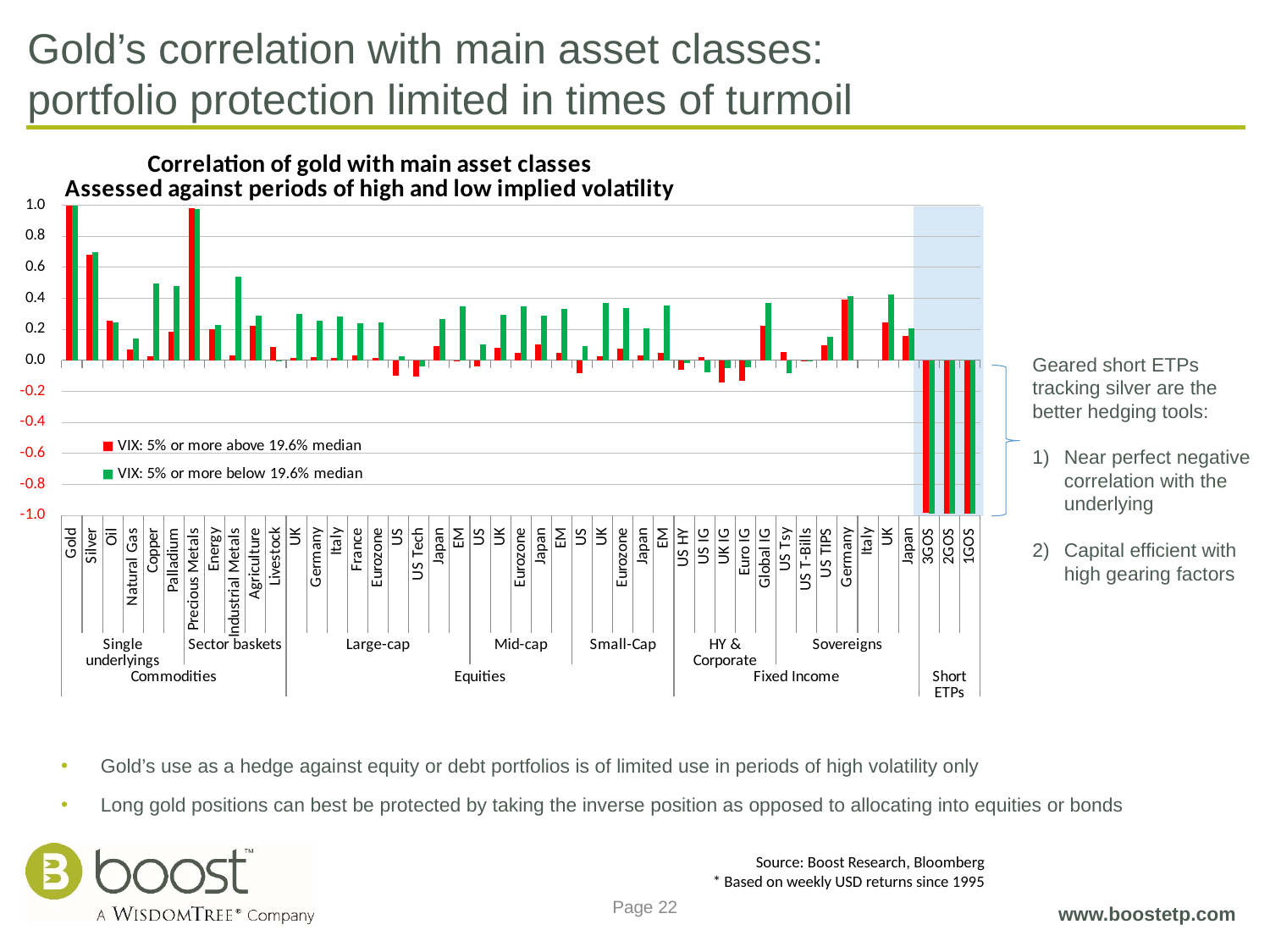
How many series does the legend list? 2 Which category has the highest correlation in the 'VIX: 5% or more above 19.6% median' series? Gold Is the value for Precious Metals in the 'VIX: 5% or more above 19.6% median' series greater or less than 0.8? greater Is the value for Oil in the 'VIX: 5% or more above 19.6% median' series greater or less than 0.4? less In the 'VIX: 5% or more above 19.6% median' series, which is larger: Silver or Oil? Silver What kind of chart is shown on the slide? bar chart How many categories are in the Short ETPs group? 3 What is the correlation value for Gold in the 'VIX: 5% or more above 19.6% median' series? 1.0 Is the value for Agriculture in the 'VIX: 5% or more below 19.6% median' series greater or less than 0.4? less What colour represents the 'VIX: 5% or more below 19.6% median' series? green